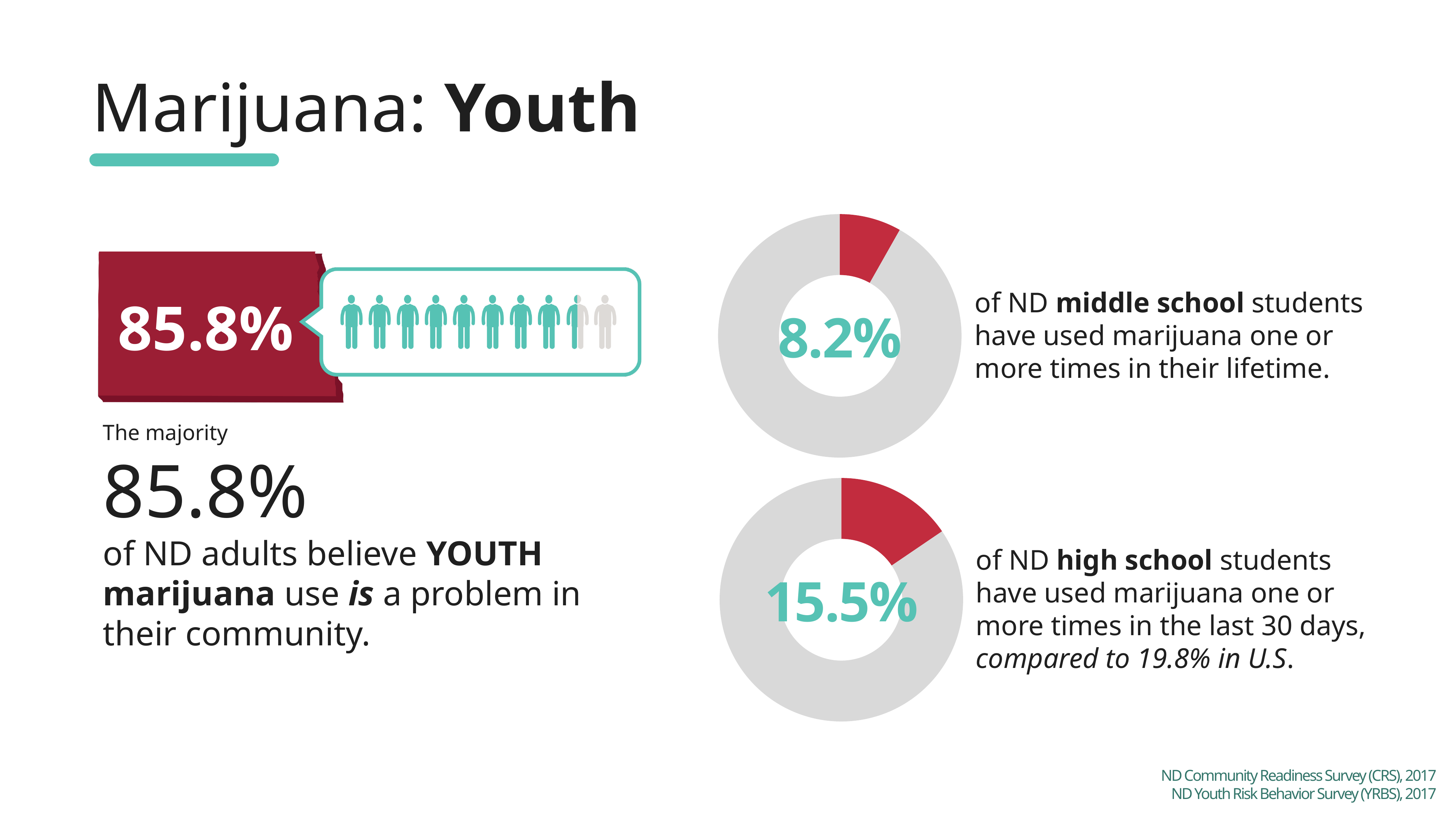
In the lower donut chart, what is the U.S. comparison figure given for high school students' marijuana use in the last 30 days? 19.8% How many person icons are shown in the pictograph on the left? 10 What kind of chart is used to show the 8.2% middle school figure? Donut chart What percentage is shown in the upper donut chart for ND middle school students who have used marijuana one or more times in their lifetime? 8.2% What percentage is shown in the pictograph on the left for ND adults who believe youth marijuana use is a problem in their community? 85.8% Is the ND high school value in the lower donut chart greater or less than the U.S. figure of 19.8%? less What percentage is shown in the lower donut chart for ND high school students who have used marijuana one or more times in the last 30 days? 15.5% What is the title of the slide? Marijuana: Youth How many donut charts are on the slide? 2 What colour is the highlighted segment in the donut charts? Red Which donut chart shows the larger highlighted share, the middle school chart or the high school chart? High school What is the difference between the high school donut chart value (15.5%) and the middle school donut chart value (8.2%)? 7.3 percentage points